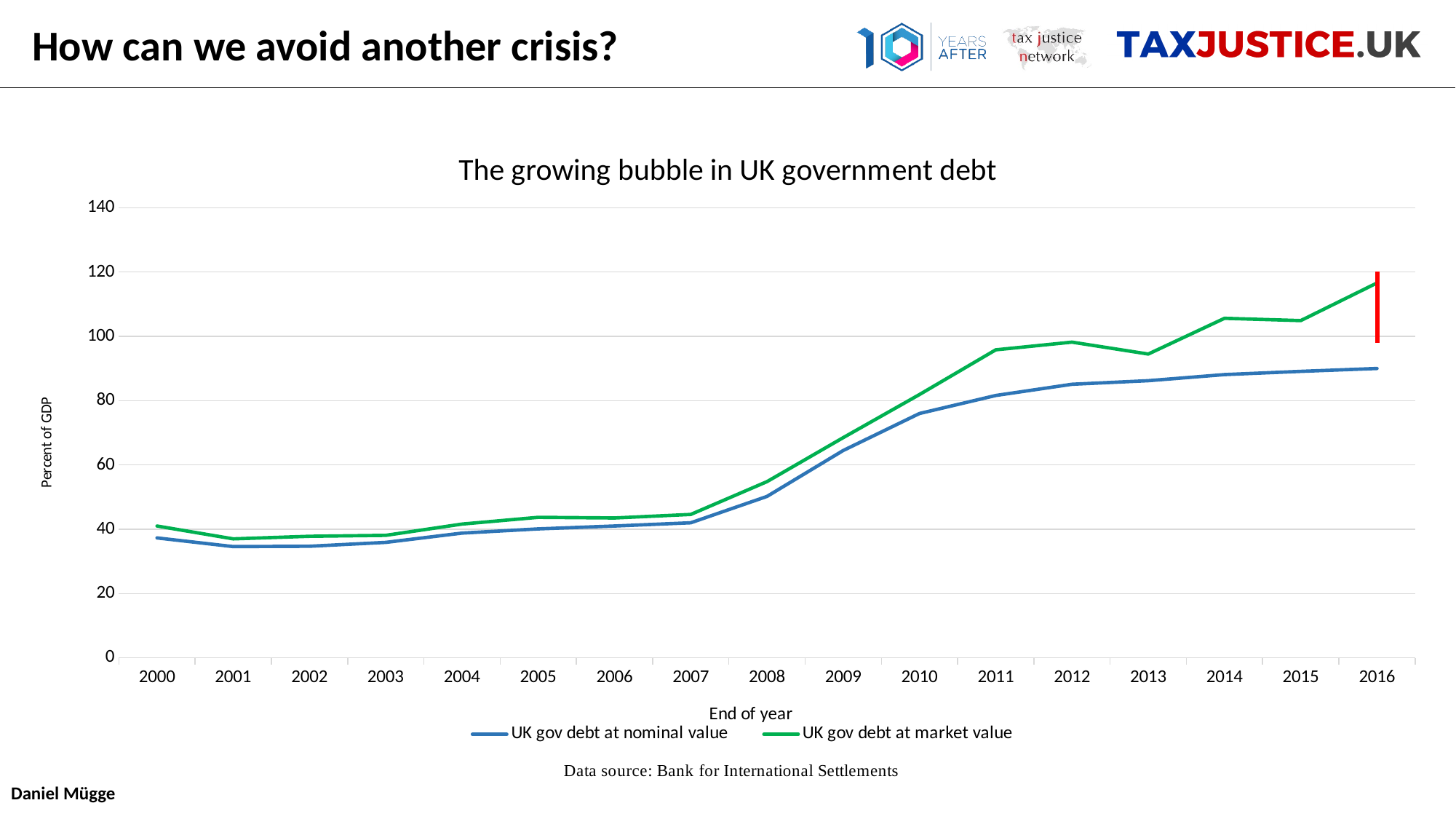
Is the value for UK gov debt at market value in 2014 greater or less than 100? greater Is the value for UK gov debt at nominal value in 2016 greater or less than 100? less What is the label on the y axis? Percent of GDP How many series does the legend list? 2 Is the value for UK gov debt at nominal value in 2000 greater or less than 40? less How many years are plotted along the x axis? 17 In 2016, which series has the higher value: UK gov debt at nominal value or UK gov debt at market value? UK gov debt at market value In which year is UK gov debt at market value highest? 2016 Does UK gov debt at nominal value rise or fall from 2007 to 2016? rise What kind of chart is shown on the slide? line chart